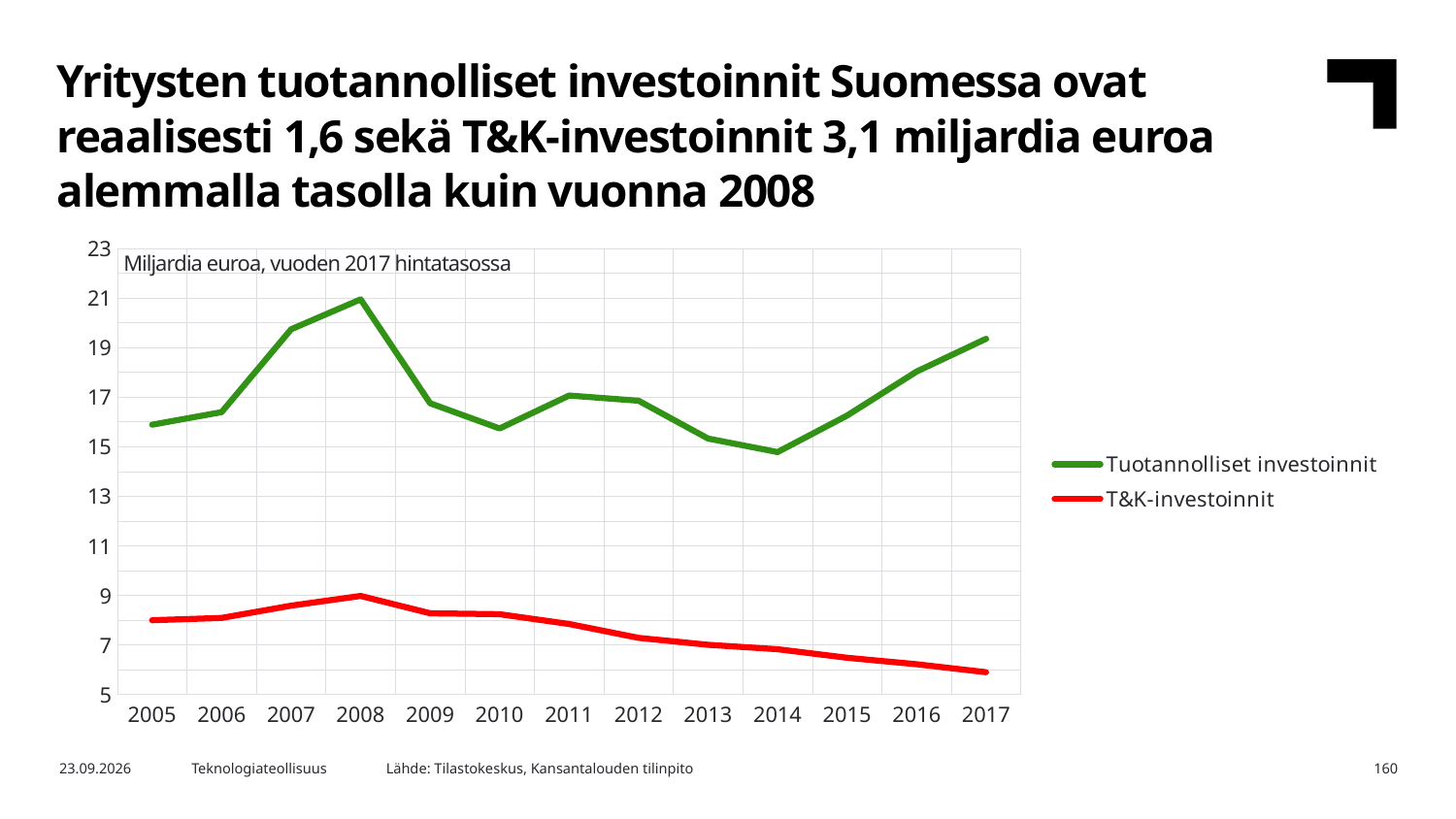
What colour is the line for T&K-investoinnit? red Which is larger: Tuotannolliset investoinnit in 2007 or in 2009? 2007 Is the value for T&K-investoinnit in 2017 greater or less than 7? less Is the value for Tuotannolliset investoinnit in 2008 greater or less than 19? greater How many series does the legend list? 2 How many years are plotted along the x axis? 13 In which year is the value for Tuotannolliset investoinnit highest? 2008 What kind of chart is shown on the slide? line chart Do the values for T&K-investoinnit rise or fall from 2008 to 2017? fall In which year is the value for T&K-investoinnit highest? 2008 In which year is the value for Tuotannolliset investoinnit lowest? 2014 In which year is the value for T&K-investoinnit lowest? 2017